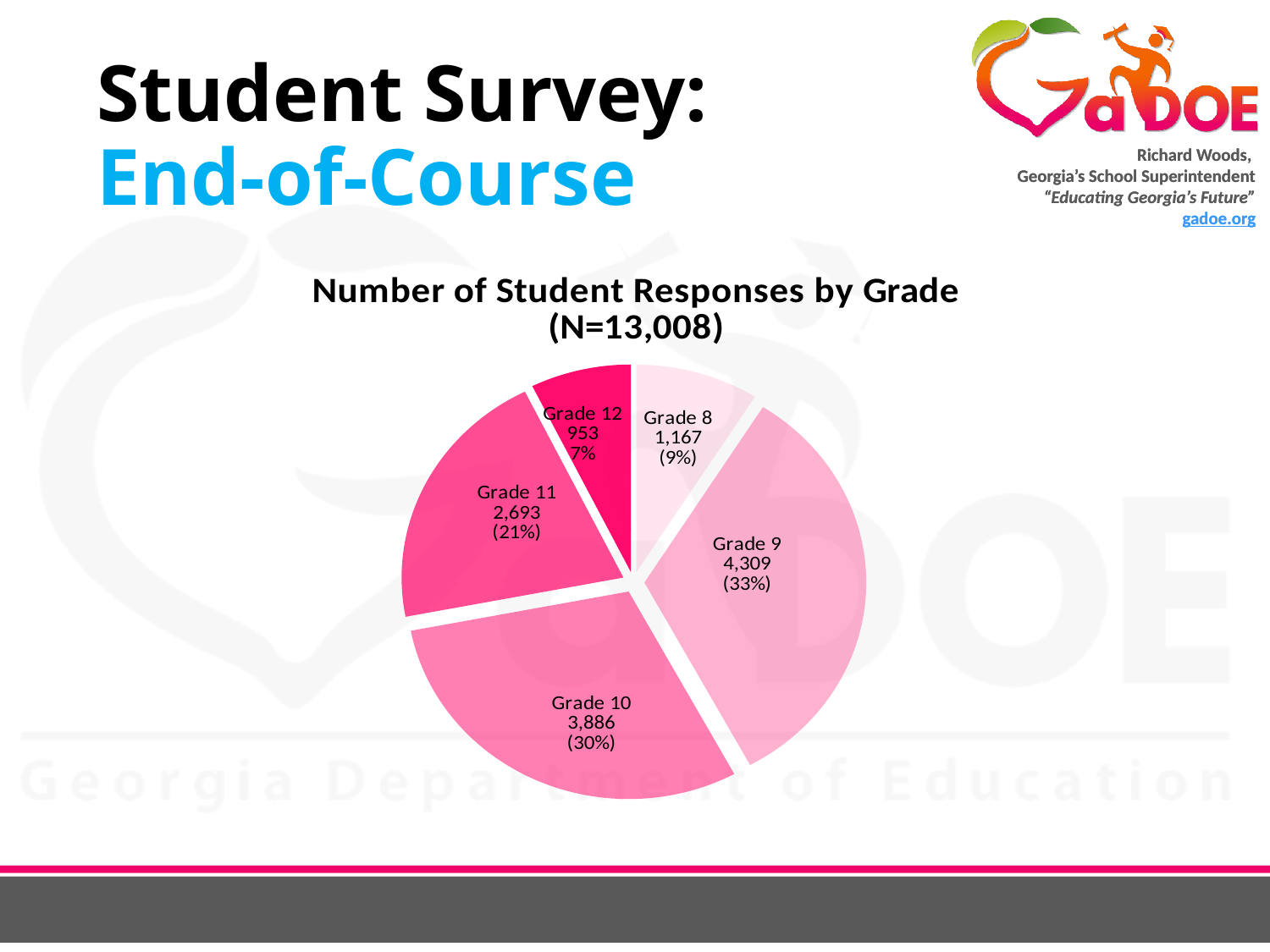
Which grade has the highest number of student responses? Grade 9 Which has more student responses, Grade 8 or Grade 11? Grade 11 How many student responses came from Grade 12? 953 Which grade has the lowest number of student responses? Grade 12 What kind of chart is shown on the slide? pie chart What share of the pie does Grade 8 represent? 9% How many student responses came from Grade 11? 2,693 How many grade categories are shown in the pie chart? 5 How many student responses came from Grade 9? 4,309 What is the difference in student responses between Grade 9 and Grade 10? 423 What share of the pie does Grade 10 represent? 30% What is the title of the chart? Number of Student Responses by Grade (N=13,008)